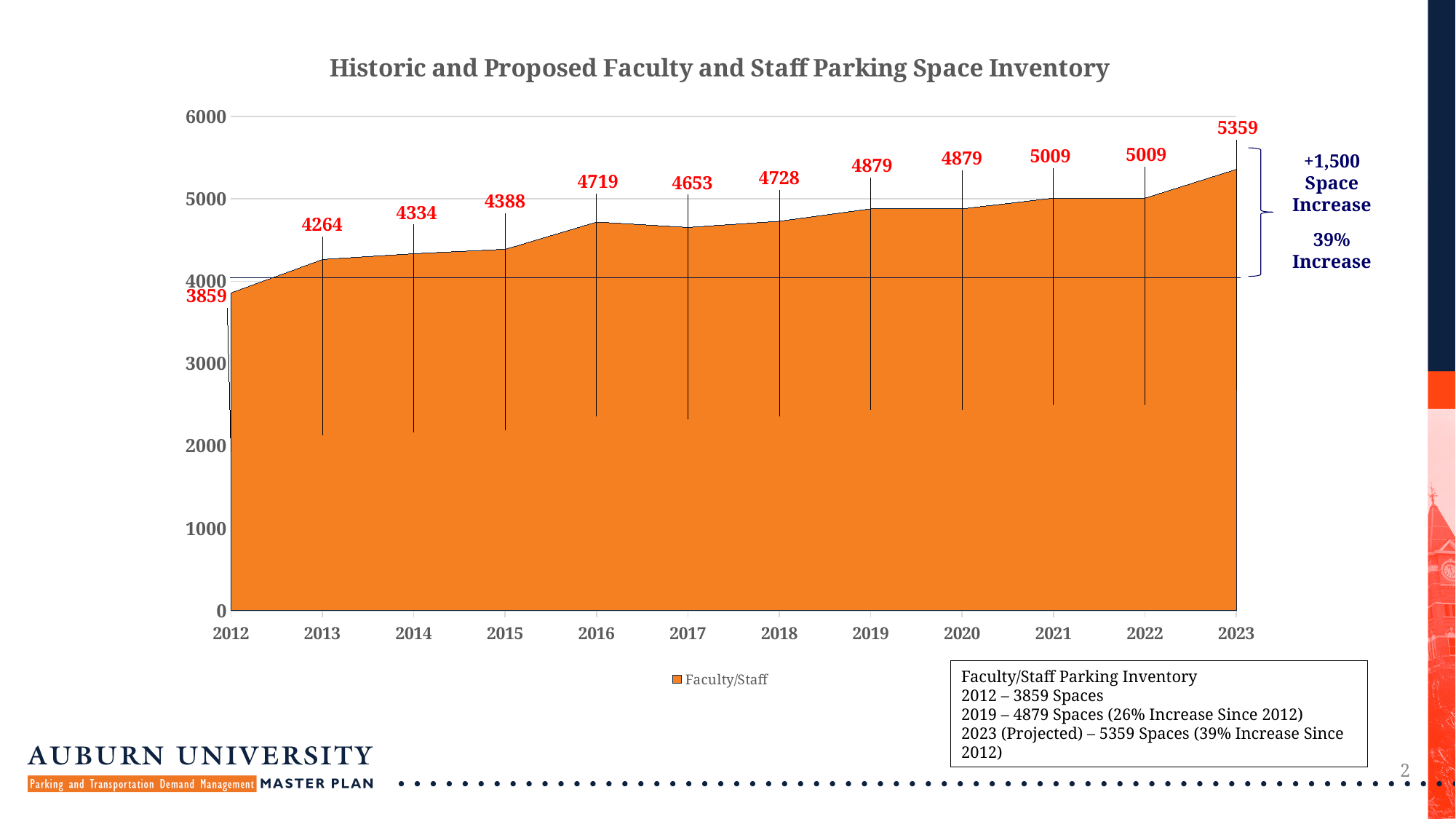
How many series does the legend list? 1 What is the Faculty/Staff parking space inventory for 2012? 3859 Which year has the highest Faculty/Staff parking space inventory? 2023 What is the projected Faculty/Staff parking space inventory for 2023? 5359 How many years are shown on the x axis? 12 What is the difference between the 2023 and 2012 Faculty/Staff parking space inventory values? 1500 Which year has the lowest Faculty/Staff parking space inventory? 2012 Is the value for 2019 greater or less than 5000? less What is the Faculty/Staff parking space inventory for 2016? 4719 Which is larger, the value for 2016 or the value for 2017? 2016 What kind of chart is shown on the slide? Area chart What is the title of the chart? Historic and Proposed Faculty and Staff Parking Space Inventory